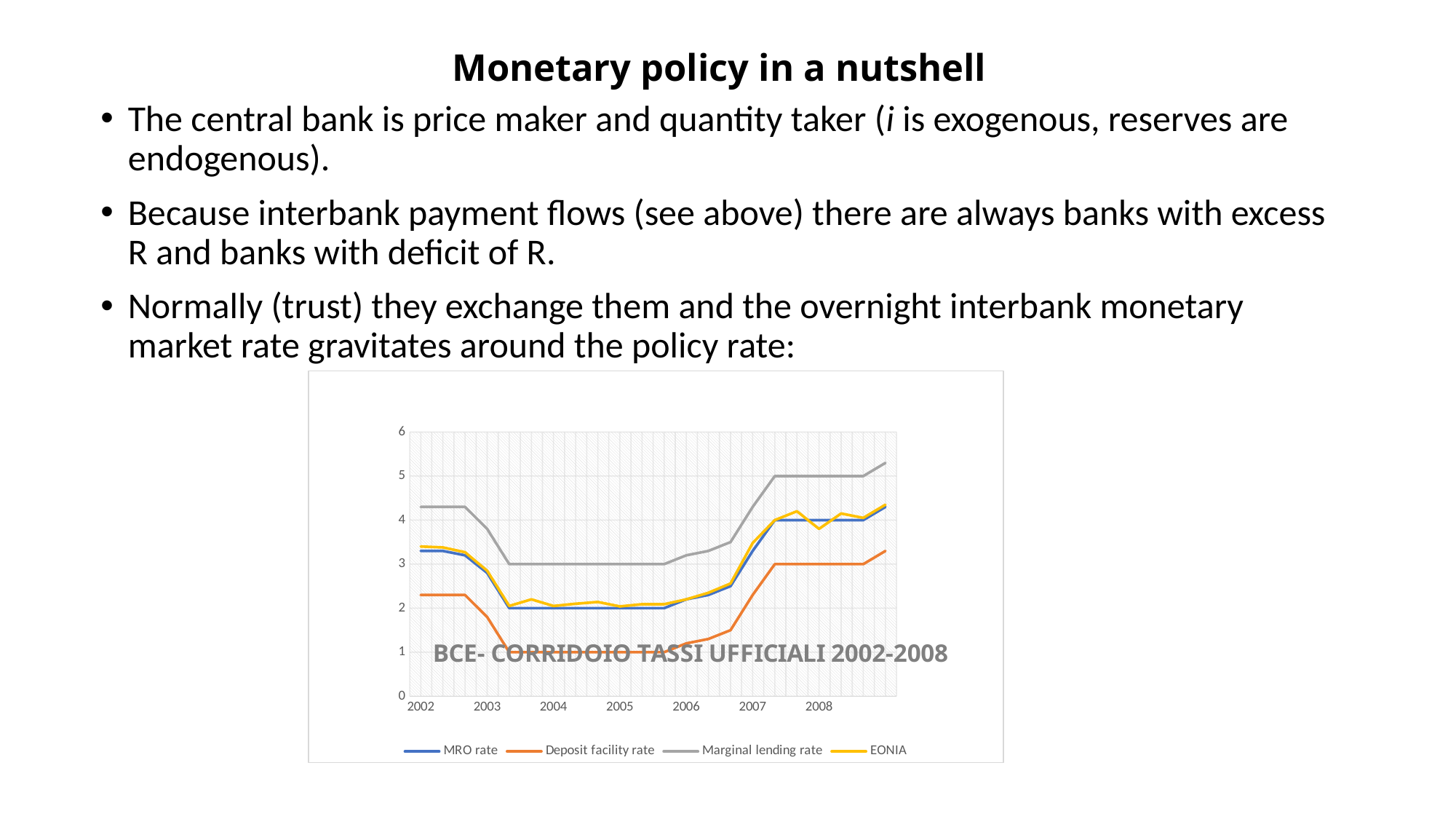
Which series has the lowest values throughout the chart? Deposit facility rate What is the title of the chart? BCE- CORRIDOIO TASSI UFFICIALI 2002-2008 Is the Marginal lending rate at 2008 greater or less than 4? greater Which series has the highest values throughout the chart? Marginal lending rate How many series does the chart legend list? 4 Is the Marginal lending rate at 2002 greater or less than 4? greater Is the MRO rate at 2004 greater or less than 3? less At 2004, which is higher: the Marginal lending rate or the Deposit facility rate? Marginal lending rate Which series is plotted in orange? Deposit facility rate What kind of chart is shown on the slide? line chart Does the Deposit facility rate rise or fall between 2006 and 2008? rise